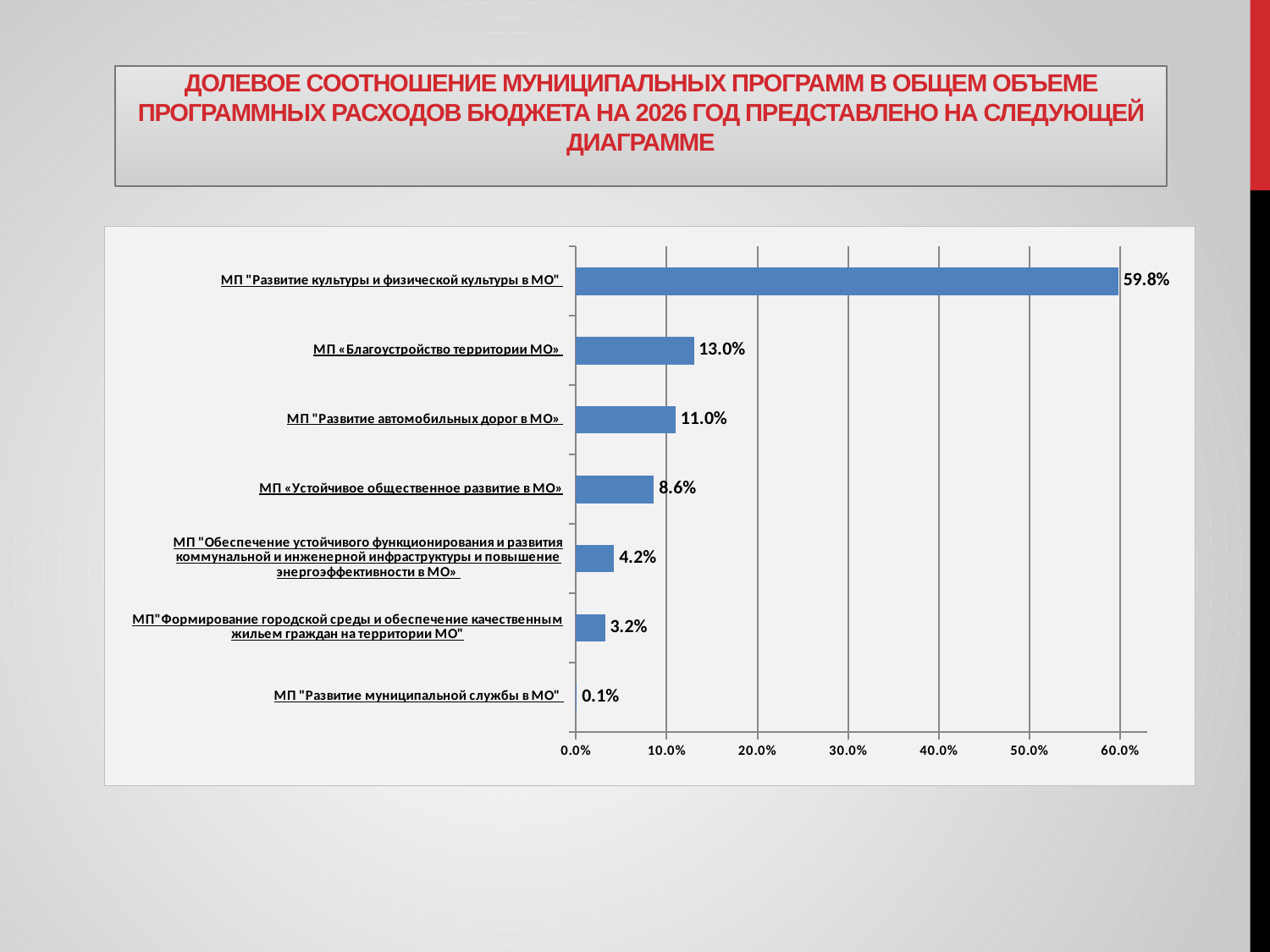
What is the value for МП «Благоустройство территории МО»? 13.0% What is the value for МП "Развитие муниципальной службы в МО"? 0.1% How many programs (categories) are shown in the chart? 7 Which is larger: the value for МП «Устойчивое общественное развитие в МО» or the value for МП"Формирование городской среды и обеспечение качественным жильем граждан на территории МО"? МП «Устойчивое общественное развитие в МО» Which program has the lowest share? МП "Развитие муниципальной службы в МО" What is the value for МП "Развитие автомобильных дорог в МО"? 11.0% Is the value for МП "Развитие культуры и физической культуры в МО" greater or less than 50.0%? greater What is the value for МП «Устойчивое общественное развитие в МО»? 8.6% What kind of chart is shown on the slide? bar chart Which program has the highest share? МП "Развитие культуры и физической культуры в МО" What is the value for МП "Развитие культуры и физической культуры в МО"? 59.8% What is the difference between the values for МП «Благоустройство территории МО» and МП "Развитие автомобильных дорог в МО"? 2.0%